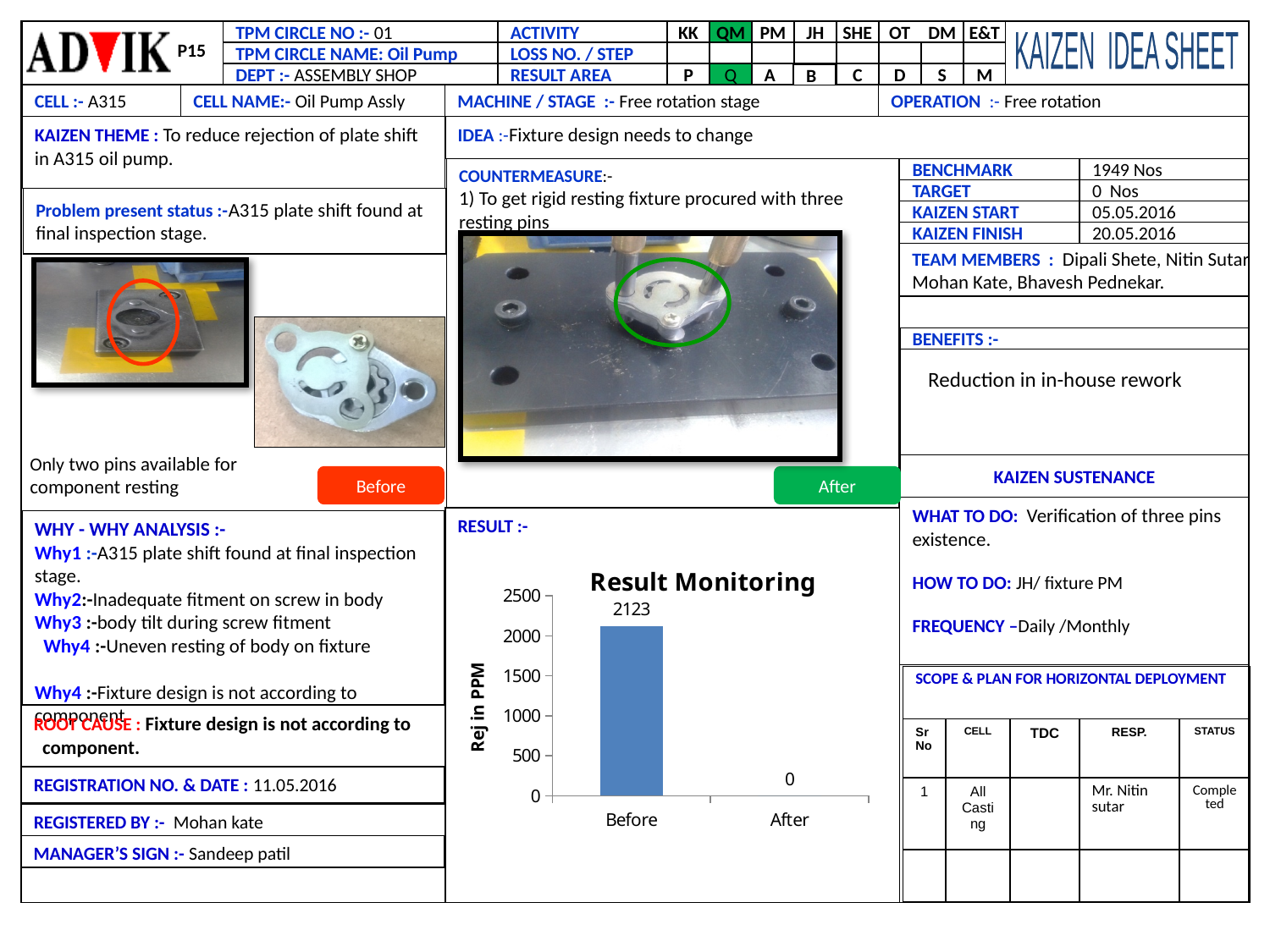
What is the y-axis label of the Result Monitoring chart? Rej in PPM Is the value for Before in the Result Monitoring chart greater or less than 2000? greater What is the title of the chart on the slide? Result Monitoring Which category has the highest value in the Result Monitoring chart? Before Which category has the lowest value in the Result Monitoring chart? After How many categories are shown on the x axis of the Result Monitoring chart? 2 What is the difference between the Before and After values in the Result Monitoring chart? 2123 What kind of chart is the Result Monitoring chart? bar chart Do the values in the Result Monitoring chart rise or fall from Before to After? fall What is the value for Before in the Result Monitoring chart? 2123 What is the value for After in the Result Monitoring chart? 0 Which is larger in the Result Monitoring chart, the Before value or the After value? Before